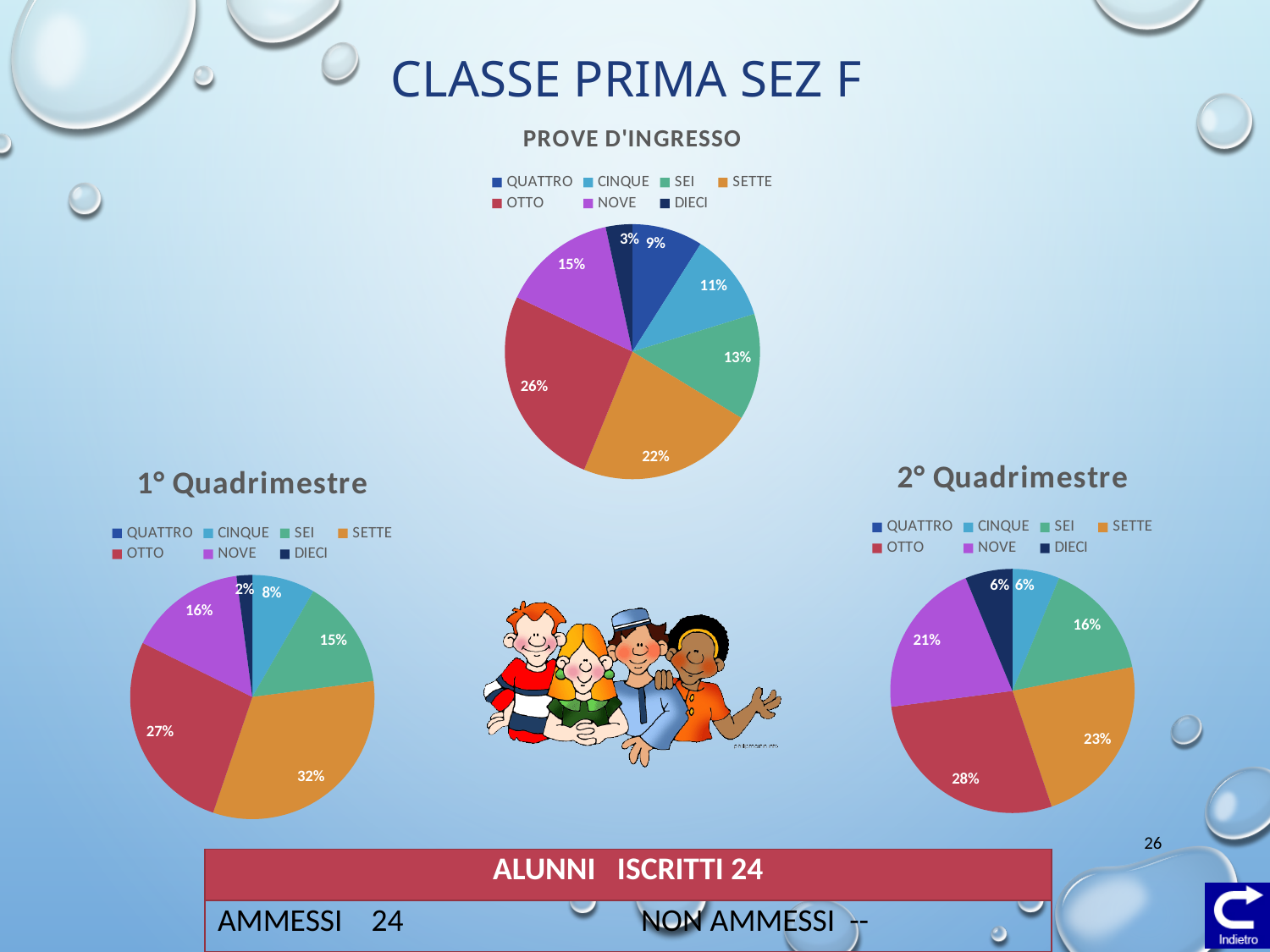
In the PROVE D'INGRESSO chart, which grade has the smallest slice? DIECI How many entries does the legend of the PROVE D'INGRESSO chart list? 7 How many pie charts are shown on the slide? 3 In the 2° Quadrimestre chart, which is larger, NOVE or SETTE? SETTE In the 1° Quadrimestre chart, what share does SETTE have? 32% In the PROVE D'INGRESSO chart, what percentage is shown for SEI? 13% In the 1° Quadrimestre chart, which grade has the largest slice? SETTE In the PROVE D'INGRESSO chart, which grade has the largest slice? OTTO What kind of chart is used for PROVE D'INGRESSO? Pie chart In the 2° Quadrimestre chart, what share does OTTO have? 28% In the 1° Quadrimestre chart, what is the difference in percentage points between SETTE and OTTO? 5 In the PROVE D'INGRESSO chart, what share does OTTO have? 26%